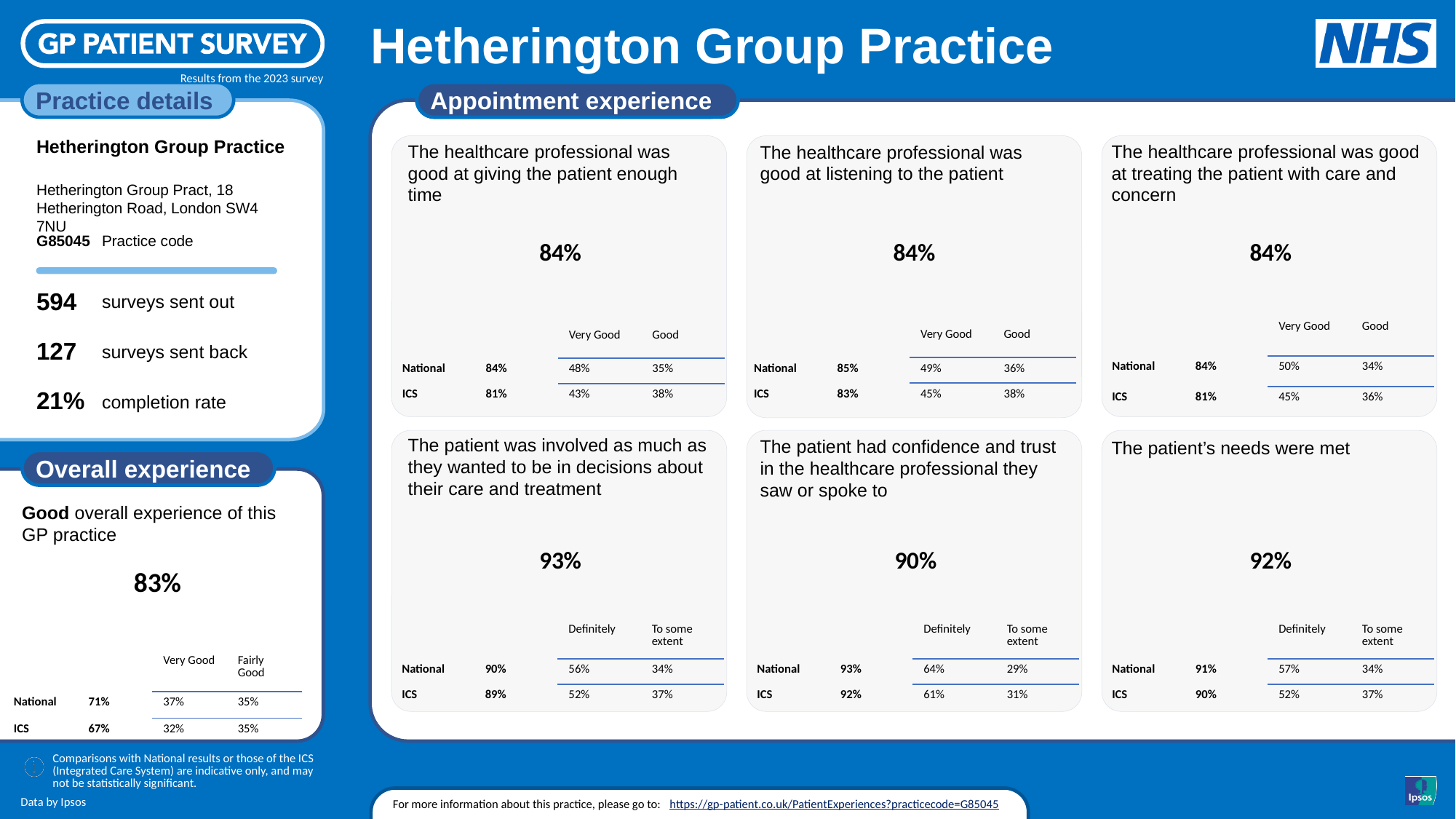
In the 'Appointment experience' section, which question has the highest practice percentage? The patient was involved as much as they wanted to be in decisions about their care and treatment In the 'Overall experience' panel, what percentage of patients reported a good overall experience of this GP practice? 83% In the 'Overall experience' panel, what is the National figure for good overall experience? 71% In the 'Overall experience' panel, what is the ICS 'Very Good' percentage? 32% In the panel 'The patient had confidence and trust in the healthcare professional they saw or spoke to', what is the ICS 'Definitely' percentage? 61% In the 'Overall experience' panel, what is the difference between the practice's 83% and the National 71%? 12 percentage points In the panel 'The patient's needs were met', is the practice's 92% higher or lower than the National 91%? higher In the panel 'The healthcare professional was good at listening to the patient', what is the National percentage? 85% In the panel 'The healthcare professional was good at treating the patient with care and concern', what is the difference between the National 84% and the ICS 81%? 3 percentage points In the 'Appointment experience' section, what percentage is shown for 'The patient was involved as much as they wanted to be in decisions about their care and treatment'? 93% In the 'Appointment experience' section, what is the practice's percentage for 'The patient's needs were met'? 92% How many question panels are shown in the 'Appointment experience' section? 6